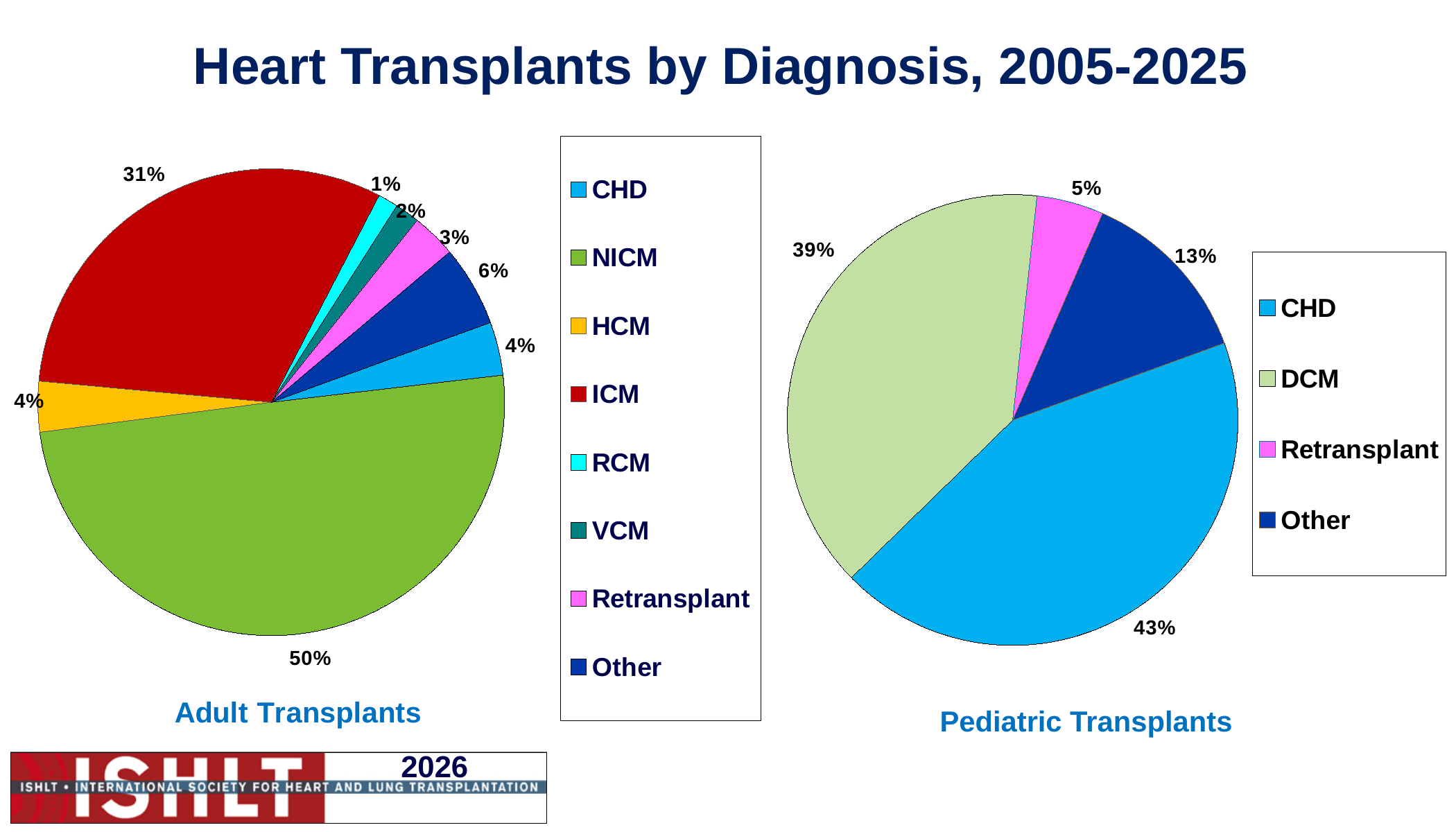
In the Pediatric Transplants pie chart, what share is CHD? 43% In the Adult Transplants pie chart, which diagnosis has the smallest share? RCM In the Pediatric Transplants pie chart, what share is DCM? 39% How many slices does the Pediatric Transplants pie chart have? 4 In the Adult Transplants pie chart, what is the difference between the NICM share and the ICM share? 19% In the Adult Transplants pie chart, which diagnosis has the largest share? NICM In the Pediatric Transplants pie chart, which diagnosis has the smallest share? Retransplant In the Pediatric Transplants pie chart, which is larger, the Other share or the Retransplant share? Other In the Adult Transplants pie chart, what share is ICM? 31% What type of chart is used for Adult Transplants? Pie chart In the Adult Transplants pie chart, what share is NICM? 50% How many entries does the legend of the Adult Transplants chart list? 8